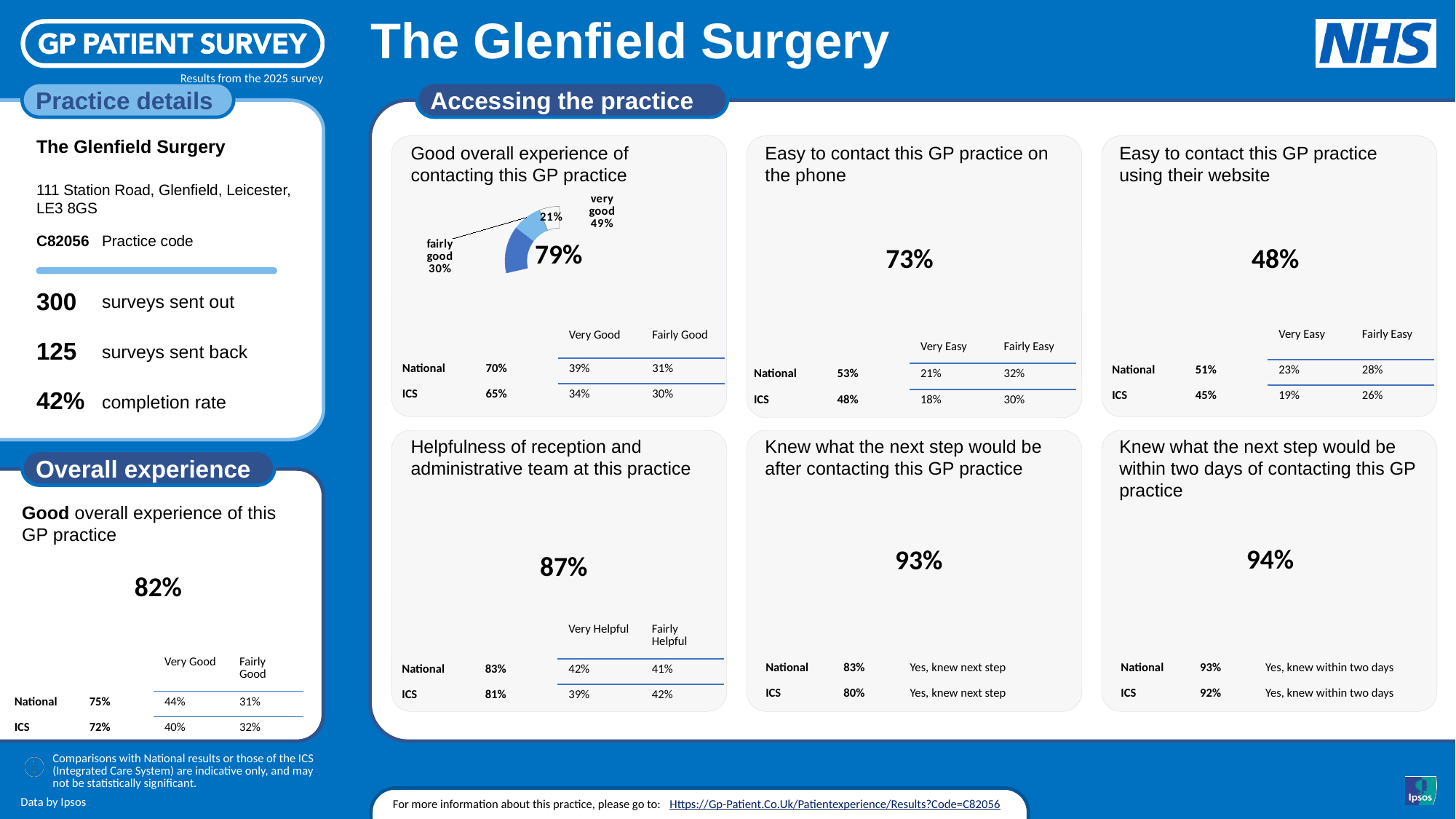
In the 'Good overall experience of contacting this GP practice' chart, what percentage is shown for 'very good'? 49% How many slices does the 'Good overall experience of contacting this GP practice' chart have? 3 Is the 'fairly good' slice in the 'Good overall experience of contacting this GP practice' chart greater or less than 25%? greater What is the large value printed in the centre of the 'Good overall experience of contacting this GP practice' chart? 79% In the 'Good overall experience of contacting this GP practice' chart, what percentage is shown for 'fairly good'? 30% In the 'Good overall experience of contacting this GP practice' chart, which labelled slice is the largest? very good What kind of chart is used in the 'Good overall experience of contacting this GP practice' panel? Doughnut (pie) chart In the 'Good overall experience of contacting this GP practice' chart, which is larger: 'very good' or 'fairly good'? very good In the 'Good overall experience of contacting this GP practice' chart, what is the value of the smallest slice? 21% In the 'Good overall experience of contacting this GP practice' chart, how many percentage points larger is 'very good' than 'fairly good'? 19% In the 'Good overall experience of contacting this GP practice' chart, what do 'very good' and 'fairly good' add up to? 79% Under which section heading does the 'Good overall experience of contacting this GP practice' chart appear? Accessing the practice